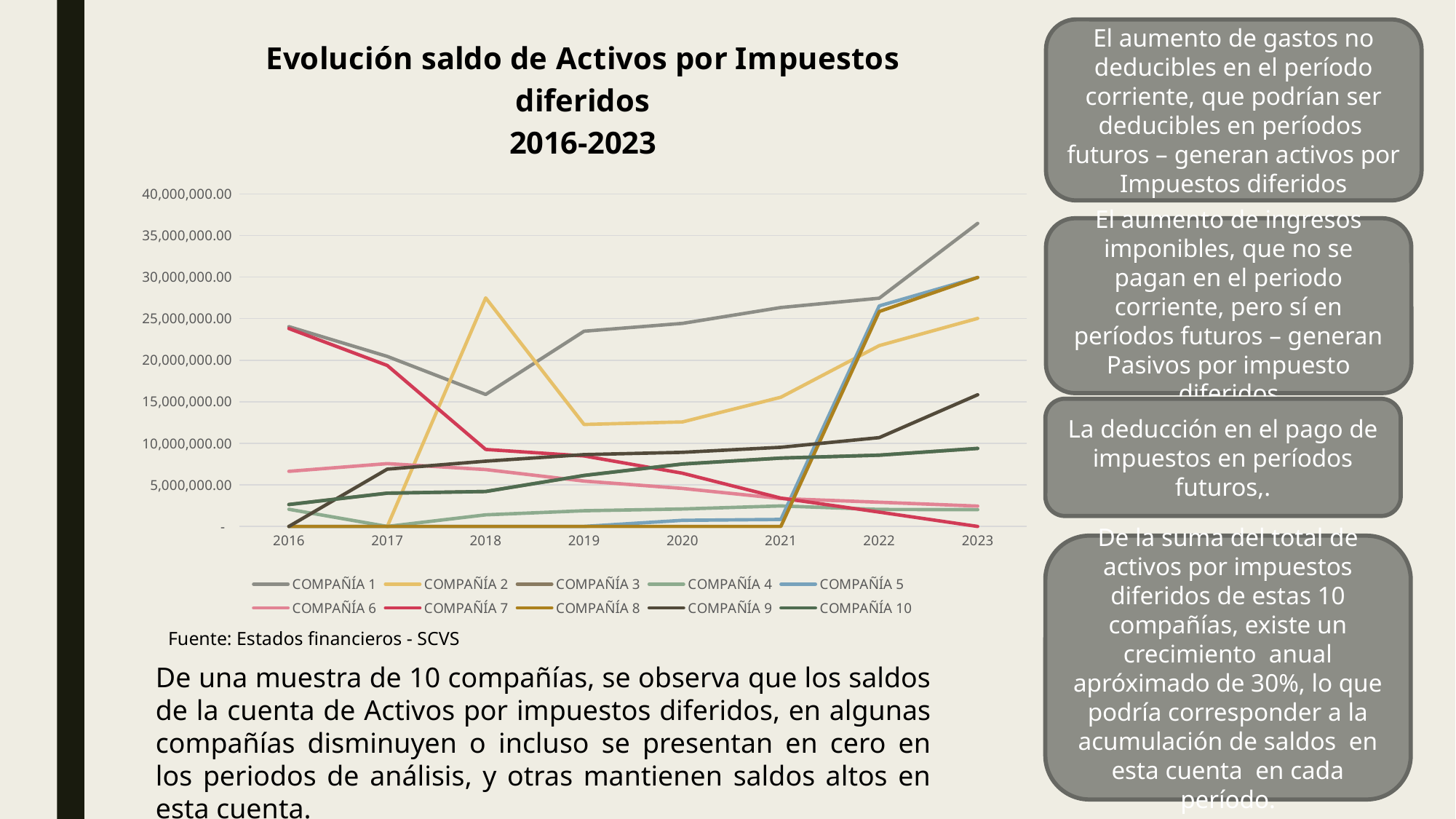
How many years are shown on the x axis? 8 Which company has the highest value in 2018? COMPAÑÍA 2 Is the value for COMPAÑÍA 9 in 2023 greater or less than 10,000,000.00? greater How many series does the legend list? 10 Is the value for COMPAÑÍA 1 in 2023 greater or less than 35,000,000.00? greater Which company has the highest value in 2023? COMPAÑÍA 1 Which company has the lowest value in 2023? COMPAÑÍA 7 Is the value for COMPAÑÍA 2 in 2018 greater or less than 25,000,000.00? greater In 2023, which is larger: the value for COMPAÑÍA 1 or COMPAÑÍA 2? COMPAÑÍA 1 Does the value for COMPAÑÍA 7 rise or fall from 2016 to 2023? Fall What kind of chart is shown on the slide? Line chart What is the title of the chart? Evolución saldo de Activos por Impuestos diferidos 2016-2023